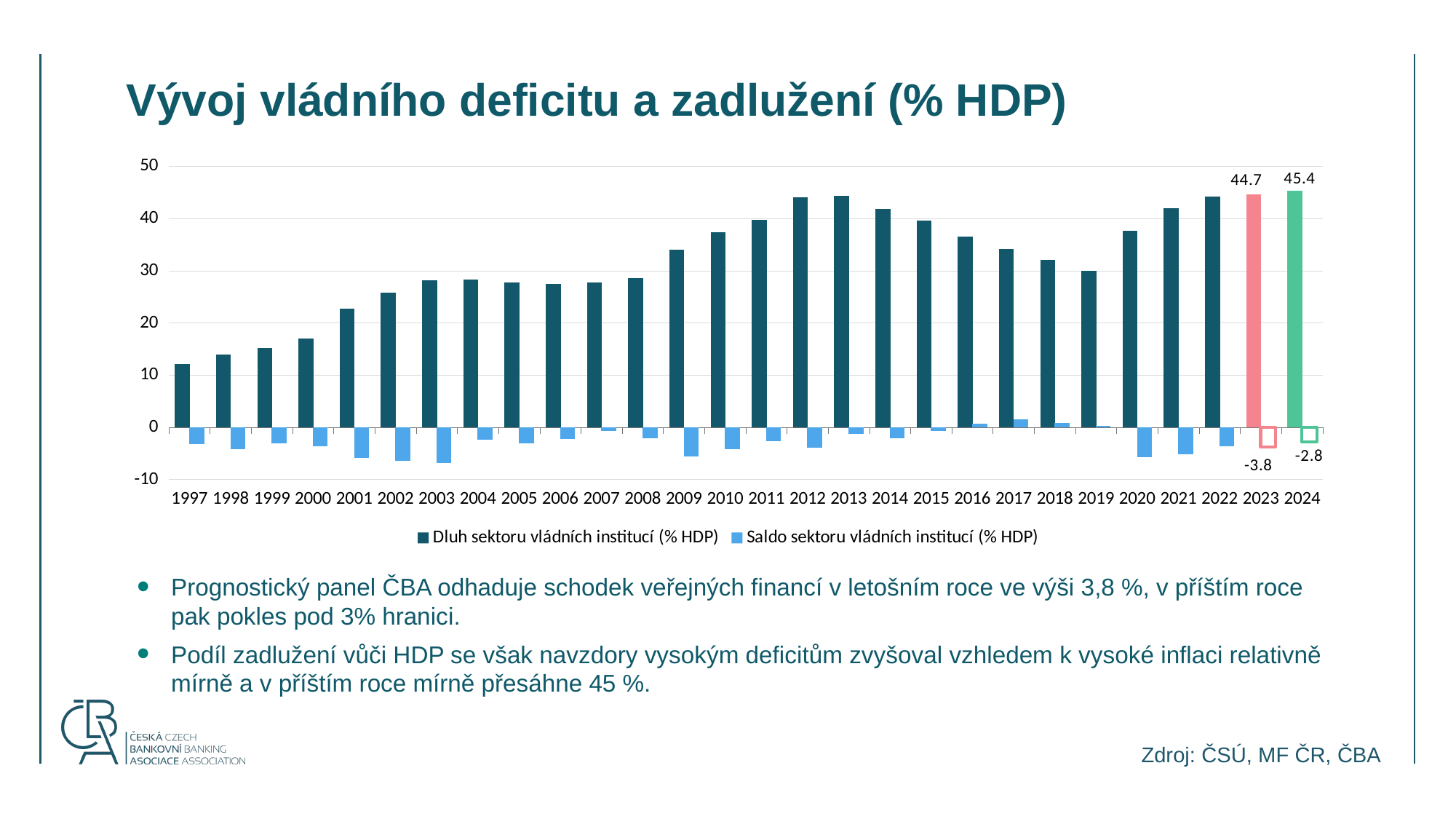
Which year has the lowest debt (Dluh) value? 1997 How many years are shown on the x axis? 28 Which year has the larger debt (Dluh) value, 2013 or 2019? 2013 By how much does the debt (Dluh) value for 2024 exceed the value for 2023? 0.7 What is the value of Saldo sektoru vládních institucí (% HDP) for 2024? -2.8 What kind of chart is shown on the slide? bar chart Is the debt (Dluh) value for 1997 greater or less than 10? greater How many series does the legend list? 2 Is the debt (Dluh) value for 2012 greater or less than 40? greater What is the value of Dluh sektoru vládních institucí (% HDP) for 2023? 44.7 What is the value of Saldo sektoru vládních institucí (% HDP) for 2023? -3.8 What is the value of Dluh sektoru vládních institucí (% HDP) for 2024? 45.4